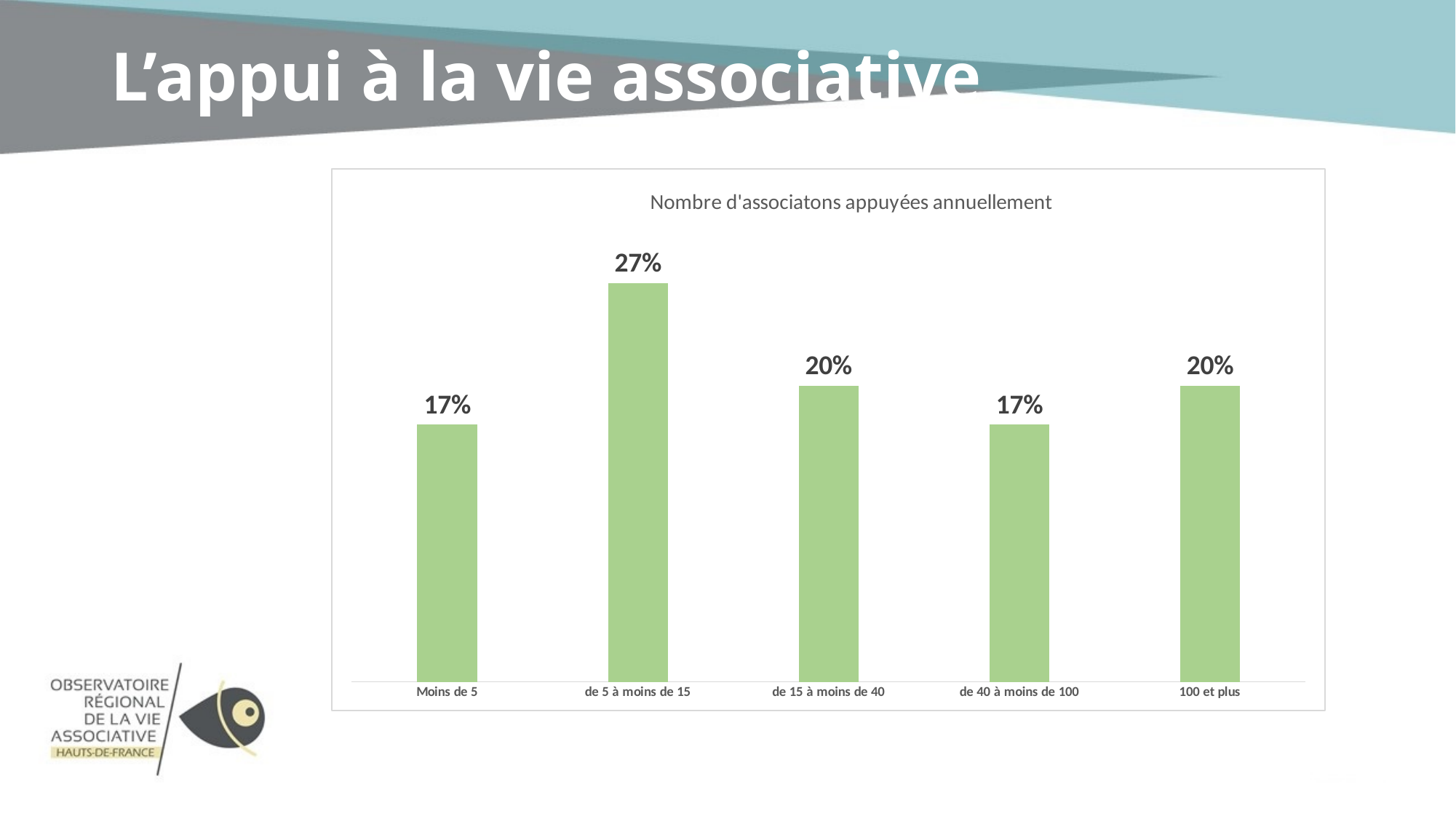
Which is larger, the value for "de 5 à moins de 15" or the value for "100 et plus"? de 5 à moins de 15 What is the value for "Moins de 5"? 17% What is the value for "100 et plus"? 20% Which category has the highest value? de 5 à moins de 15 What is the value for "de 15 à moins de 40"? 20% What is the difference between the values for "de 5 à moins de 15" and "Moins de 5"? 10% What is the value for "de 5 à moins de 15"? 27% What is the value for "de 40 à moins de 100"? 17% What is the difference between the values for "de 15 à moins de 40" and "de 40 à moins de 100"? 3% What kind of chart is shown on the slide? bar chart How many categories are shown on the x axis? 5 What is the title of the chart? Nombre d'associatons appuyées annuellement